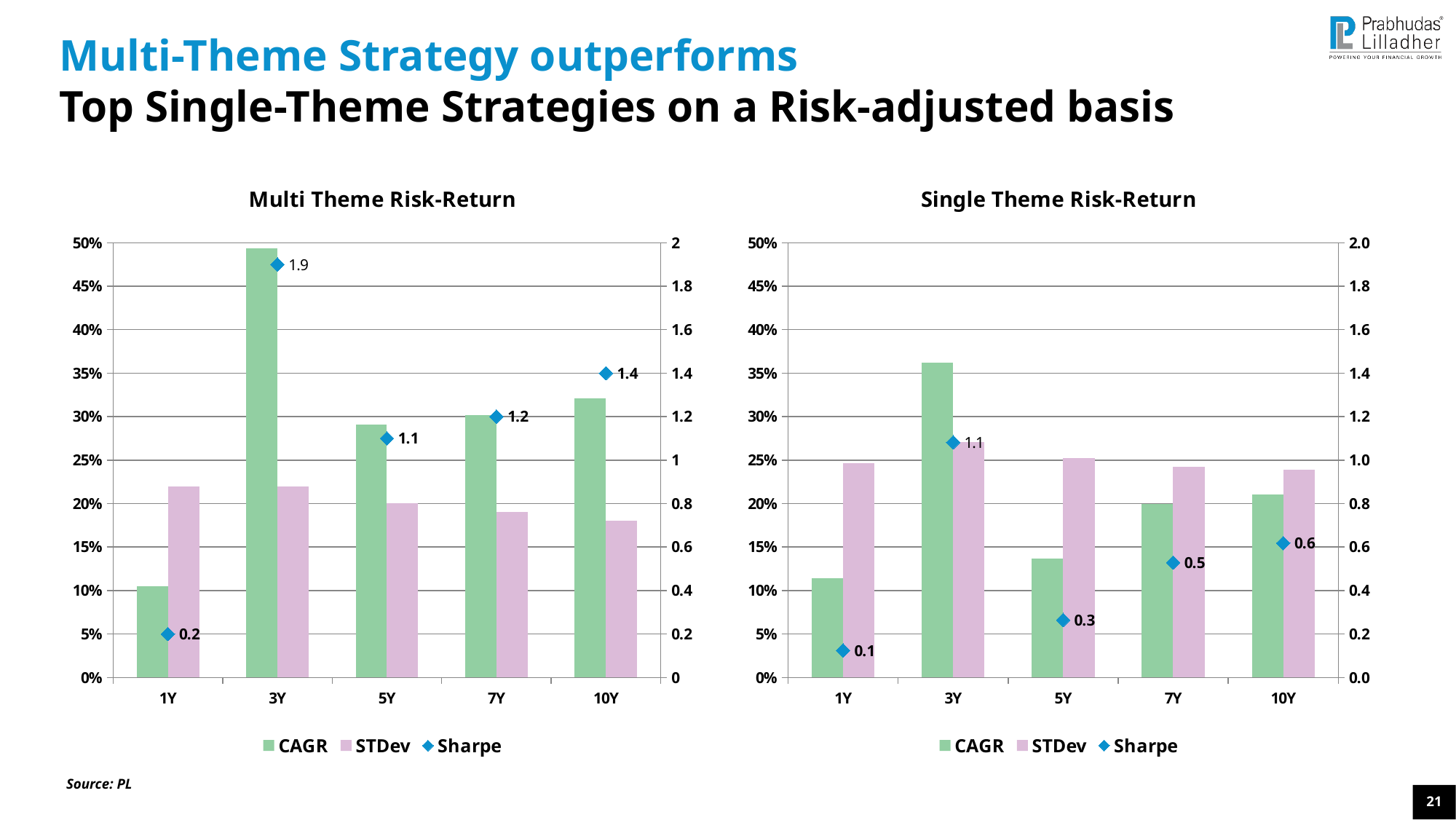
Which is larger: the 10Y Sharpe value in the Multi Theme Risk-Return chart or the 10Y Sharpe value in the Single Theme Risk-Return chart? Multi Theme Risk-Return (1.4) In the Multi Theme Risk-Return chart, what is the Sharpe value for 3Y? 1.9 In the Multi Theme Risk-Return chart, which period has the highest Sharpe value? 3Y In the Single Theme Risk-Return chart, what is the Sharpe value for 10Y? 0.6 In the Single Theme Risk-Return chart, which period has the lowest Sharpe value? 1Y In the Multi Theme Risk-Return chart, what is the difference between the Sharpe values for 3Y and 1Y? 1.7 What kind of chart is used to plot CAGR and STDev in the Multi Theme Risk-Return chart? bar chart How many periods are shown on the x axis of the Single Theme Risk-Return chart? 5 How many series does the legend of the Multi Theme Risk-Return chart list? 3 In the Single Theme Risk-Return chart, is the CAGR bar for 5Y greater or less than 15%? less In the Single Theme Risk-Return chart, do the Sharpe values rise or fall from 5Y to 10Y? rise In the Multi Theme Risk-Return chart, is the CAGR bar for 3Y greater or less than 45%? greater